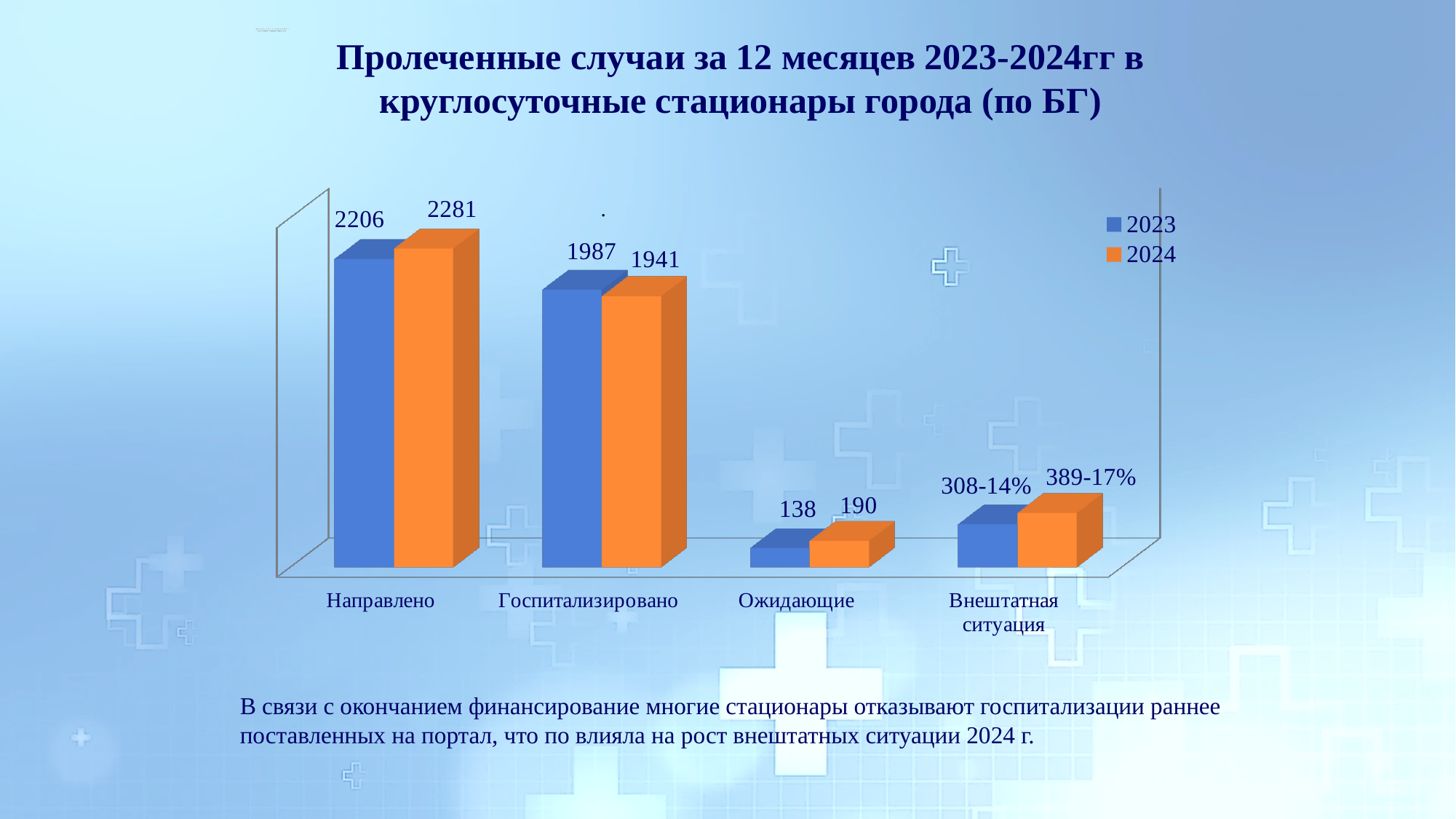
What is the value for 2023 in the Госпитализировано category? 1987 What is the data label shown for 2024 in the Внештатная ситуация category? 389-17% How many categories are shown on the x axis? 4 What is the value for 2023 in the Направлено category? 2206 Which is larger in the Госпитализировано category, the 2023 value or the 2024 value? 2023 What is the value for 2024 in the Направлено category? 2281 Which category has the lowest value for the 2024 series? Ожидающие What is the difference between the 2024 and 2023 values in the Направлено category? 75 How many series does the legend list? 2 What is the value for 2024 in the Ожидающие category? 190 Which category has the highest value for the 2023 series? Направлено What kind of chart is shown on the slide? Bar chart